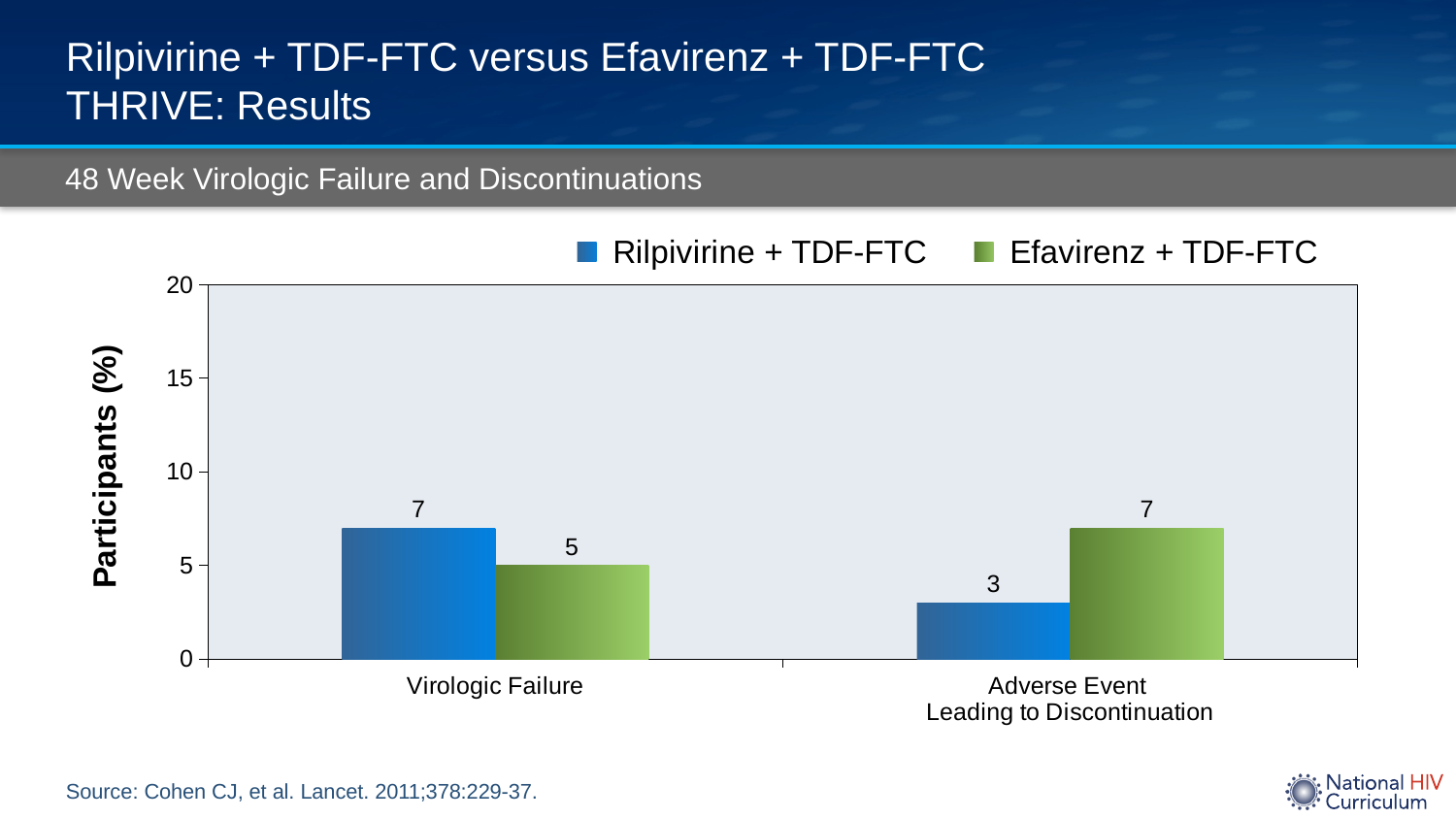
What is the difference between the Rilpivirine + TDF-FTC and Efavirenz + TDF-FTC values for Virologic Failure? 2 What kind of chart is shown on the slide? bar chart How many categories are shown on the x axis? 2 How many series does the legend list? 2 What is the value for Efavirenz + TDF-FTC in the Adverse Event Leading to Discontinuation category? 7 What is the value for Efavirenz + TDF-FTC in the Virologic Failure category? 5 What is the value for Rilpivirine + TDF-FTC in the Adverse Event Leading to Discontinuation category? 3 Which series has the lower value in the Adverse Event Leading to Discontinuation category? Rilpivirine + TDF-FTC Which is larger: the Rilpivirine + TDF-FTC value for Virologic Failure or the Rilpivirine + TDF-FTC value for Adverse Event Leading to Discontinuation? Virologic Failure What is the value for Rilpivirine + TDF-FTC in the Virologic Failure category? 7 What is the difference between the Efavirenz + TDF-FTC and Rilpivirine + TDF-FTC values for Adverse Event Leading to Discontinuation? 4 Is the Efavirenz + TDF-FTC value for Virologic Failure greater or less than 10? less